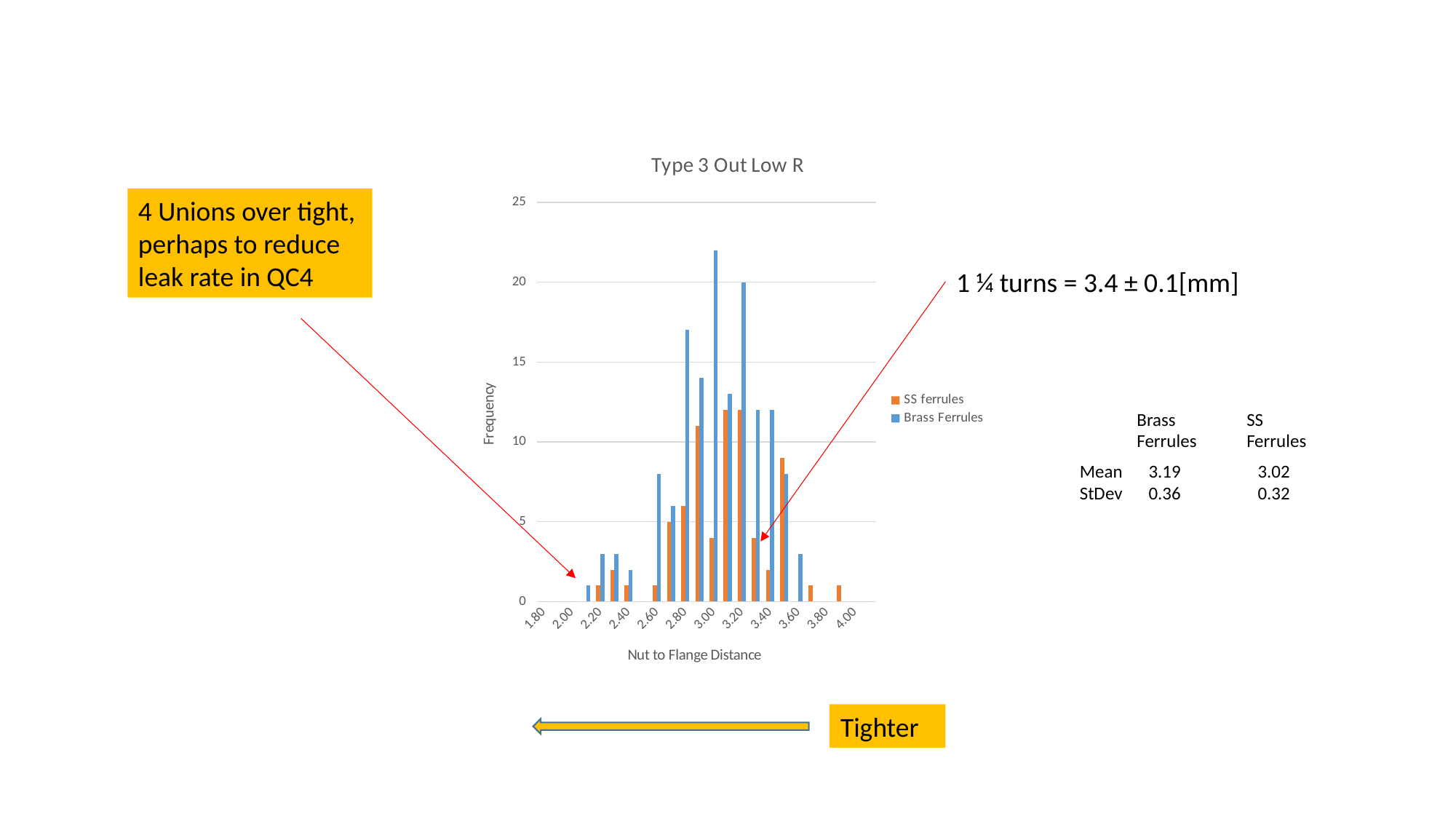
Is the SS ferrules bar at 3.80 greater or less than 5? less What are the two series named in the chart legend? SS ferrules and Brass Ferrules Which series has the tallest bar in the chart? Brass Ferrules What is the title of the chart? Type 3 Out Low R Is the tallest Brass Ferrules bar greater or less than 20? greater How many tick labels are shown on the x axis of the chart? 12 Is the tallest SS ferrules bar greater or less than 15? less Which series reaches a higher frequency, SS ferrules or Brass Ferrules? Brass Ferrules How many series does the legend of the chart list? 2 What kind of chart is shown on the slide? bar chart